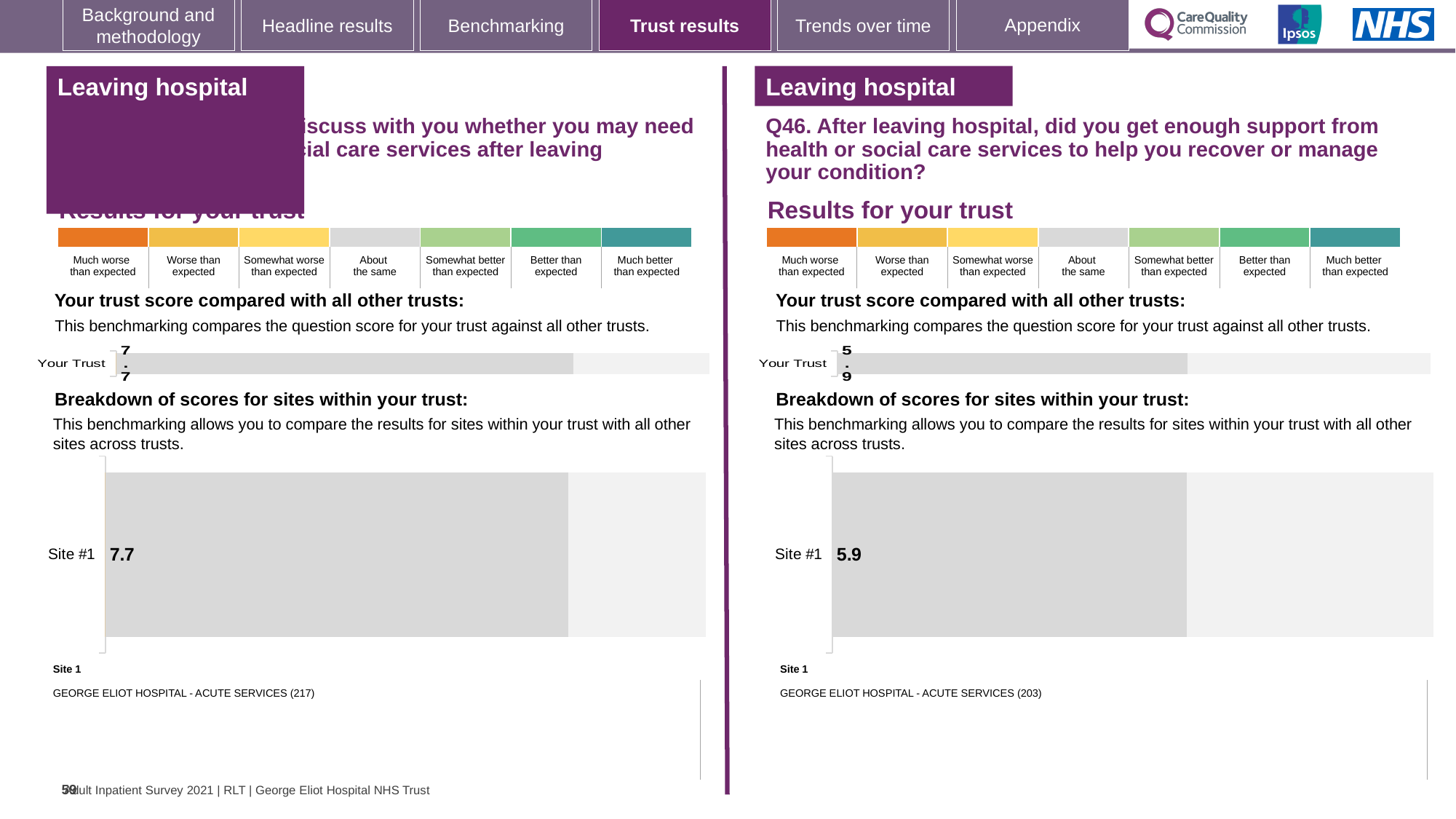
On the right half of the slide (Q46), what is the score shown for Your Trust? 5.9 What is the difference between the Site #1 score on the left half of the slide and the Site #1 score for Q46 on the right half? 1.8 How many sites are shown in the site breakdown chart on the left half of the slide? 1 In the site breakdown chart for Q46 on the right half of the slide, what is the score for Site #1? 5.9 Which site is listed as Site 1 in the breakdown for Q46 on the right half of the slide? GEORGE ELIOT HOSPITAL - ACUTE SERVICES (203) Which is larger: the Your Trust score on the left half of the slide or the Your Trust score for Q46 on the right half? The left half (7.7) What type of chart is used to show the Site #1 score for Q46 on the right half of the slide? Bar chart Which site is listed as Site 1 in the breakdown on the left half of the slide? GEORGE ELIOT HOSPITAL - ACUTE SERVICES (217) On the left half of the slide, what is the score shown for Your Trust? 7.7 In the site breakdown chart on the left half of the slide, what is the score for Site #1? 7.7 How many sites are shown in the site breakdown chart for Q46 on the right half of the slide? 1